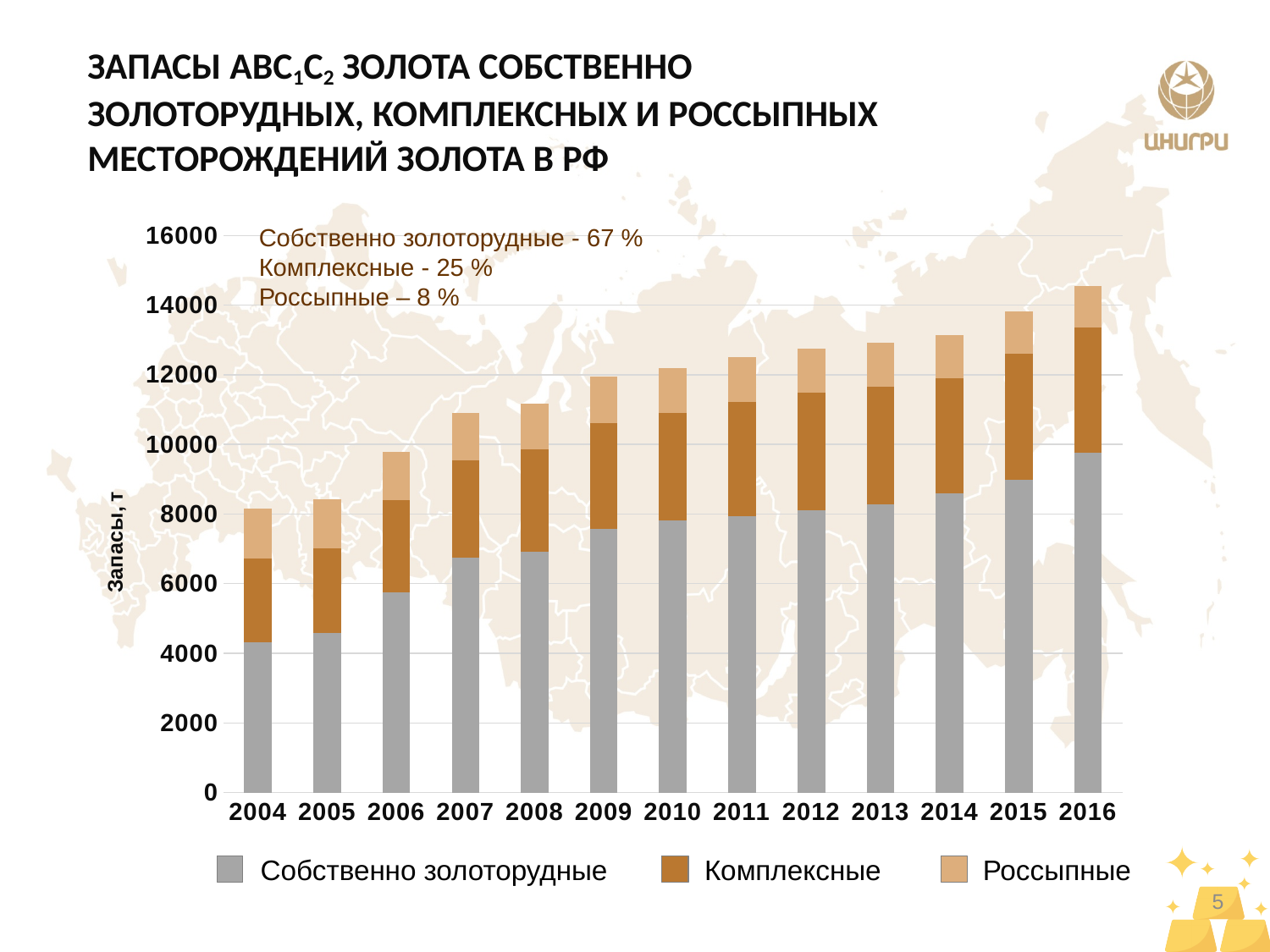
Is the value of Собственно золоторудные for 2006 greater or less than 6000? less Which year has the highest total stacked bar? 2016 According to the text on the chart, what share do Комплексные deposits account for? 25 % Is the total stacked value for 2007 greater or less than 10000? greater How many years are shown on the x axis of the chart? 13 Is the total stacked value for 2016 greater or less than 14000? greater Which is larger, the total stacked bar for 2005 or for 2006? 2006 Which year has the lowest total stacked bar? 2004 How many series does the chart legend list? 3 Do the total reserves rise or fall from 2004 to 2016? rise What kind of chart is shown on the slide? stacked bar chart